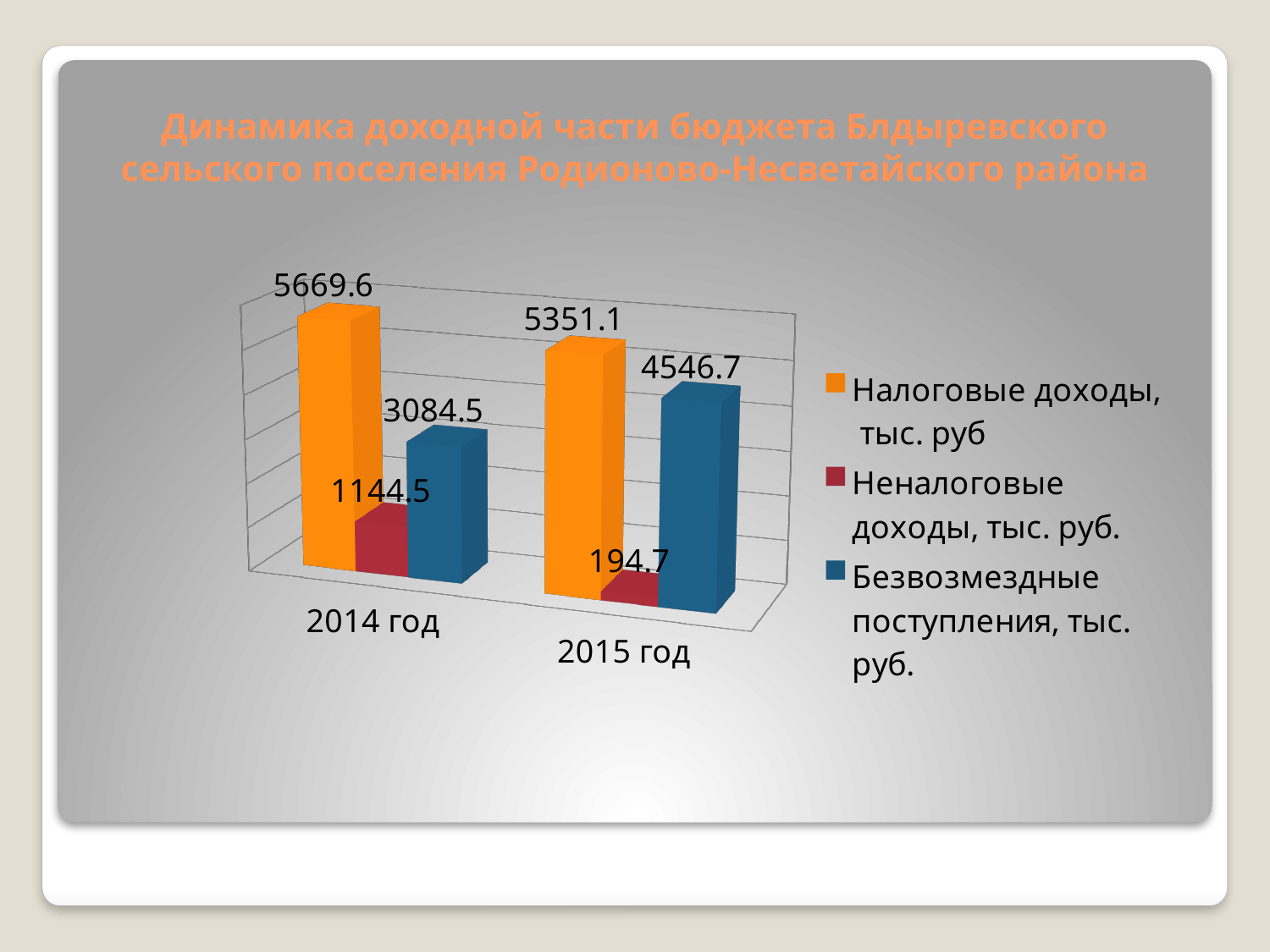
How many series does the legend list? 3 How many year categories are shown on the x axis? 2 What is the value of Неналоговые доходы for 2015 год? 194.7 Which is larger: Безвозмездные поступления in 2014 год or in 2015 год? 2015 год What is the difference between Налоговые доходы in 2014 год and 2015 год? 318.5 What is the value of Налоговые доходы for 2014 год? 5669.6 Which series has the highest value in 2015 год? Налоговые доходы, тыс. руб Which series has the lowest value in 2014 год? Неналоговые доходы, тыс. руб. What is the difference between Неналоговые доходы in 2014 год and 2015 год? 949.8 What is the value of Безвозмездные поступления for 2014 год? 3084.5 What kind of chart is shown on the slide? Bar chart What is the value of Безвозмездные поступления for 2015 год? 4546.7